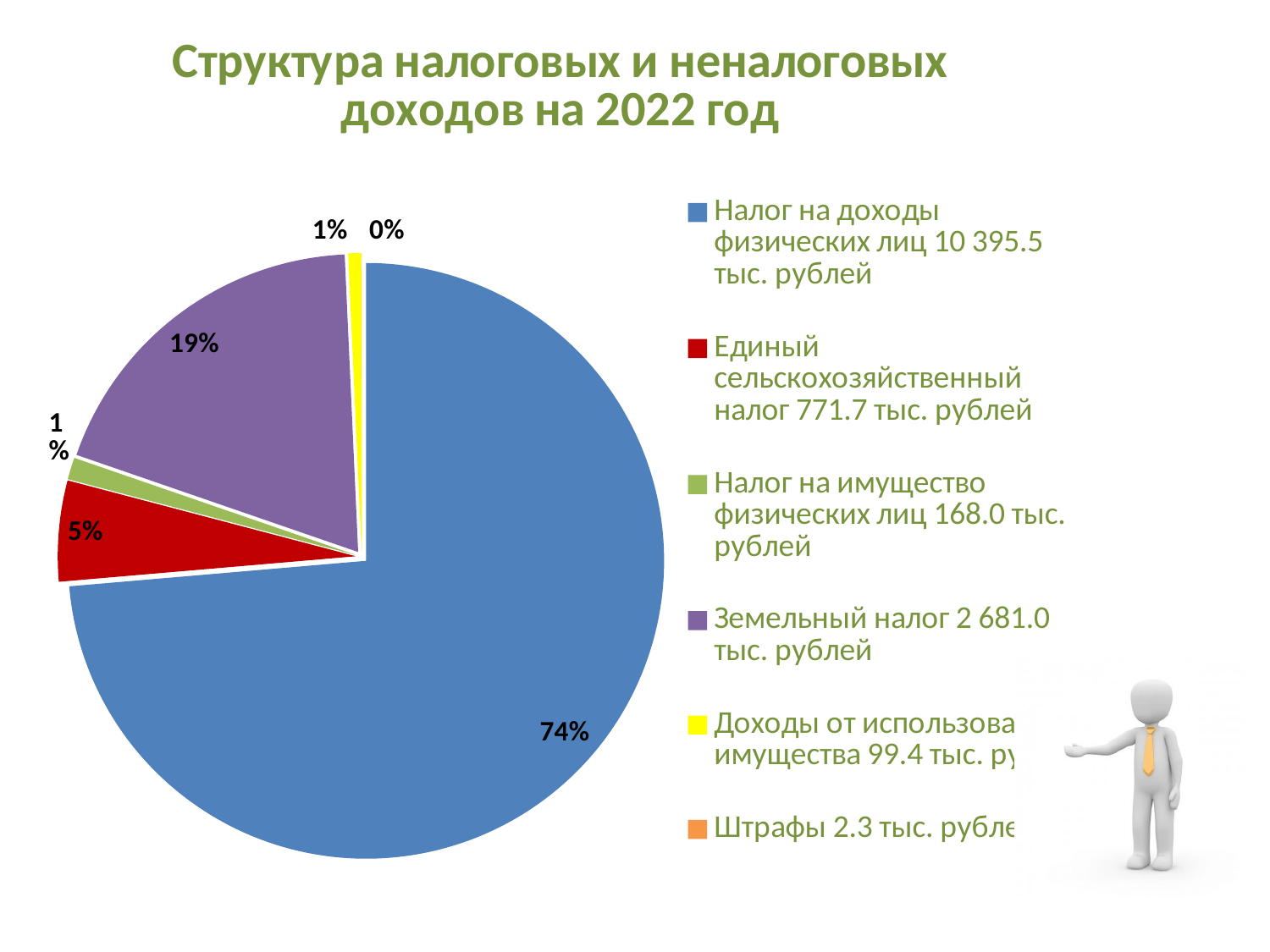
What is the title of the chart? Структура налоговых и неналоговых доходов на 2022 год What share of the pie does Налог на доходы физических лиц take? 74% What share of the pie does Штрафы take? 0% What share of the pie does Единый сельскохозяйственный налог take? 5% Which category has the largest slice of the pie? Налог на доходы физических лиц Which is larger: the share for Земельный налог or the share for Единый сельскохозяйственный налог? Земельный налог How many slices does the pie chart have? 6 Which category has the smallest slice of the pie? Штрафы What kind of chart is shown on the slide? pie chart According to the legend, what amount is given for Земельный налог? 2 681.0 тыс. рублей By how many percentage points does the share of Налог на доходы физических лиц exceed the share of Земельный налог? 55 percentage points